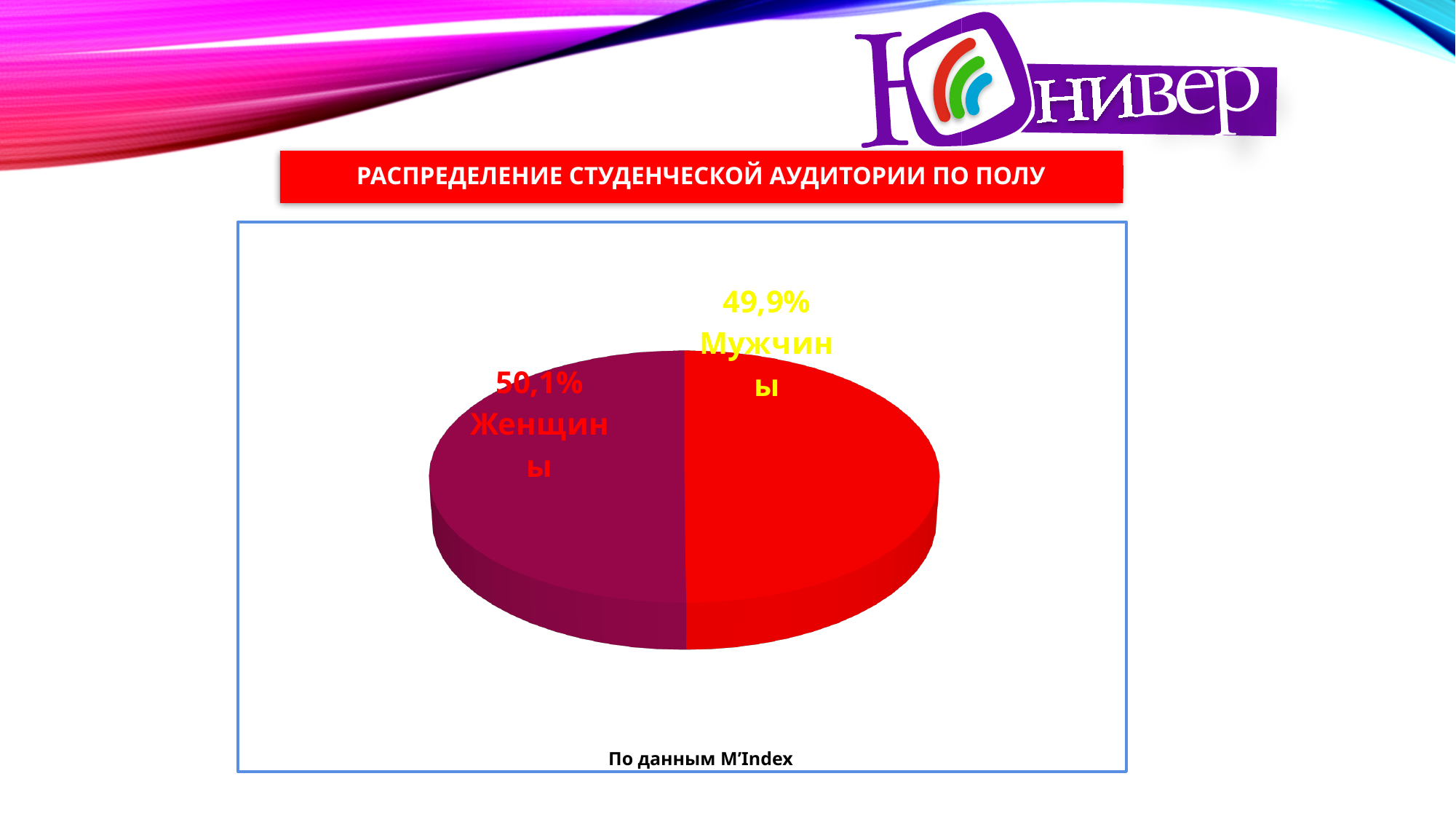
What data source is cited below the pie chart? M’Index What is the title of the chart on the slide? РАСПРЕДЕЛЕНИЕ СТУДЕНЧЕСКОЙ АУДИТОРИИ ПО ПОЛУ What is the difference in percentage points between the Женщины and Мужчины slices? 0,2% Which category has the smallest share in the pie chart? Мужчины What share of the student audience is Женщины according to the pie chart? 50,1% Is the share for Мужчины greater or less than 50%? less Is the share for Женщины greater or less than 50%? greater How many slices does the pie chart have? 2 What share of the student audience is Мужчины according to the pie chart? 49,9% Which category has the largest share in the pie chart? Женщины Which slice of the pie chart is larger, Женщины or Мужчины? Женщины What type of chart is shown on the slide? Pie chart